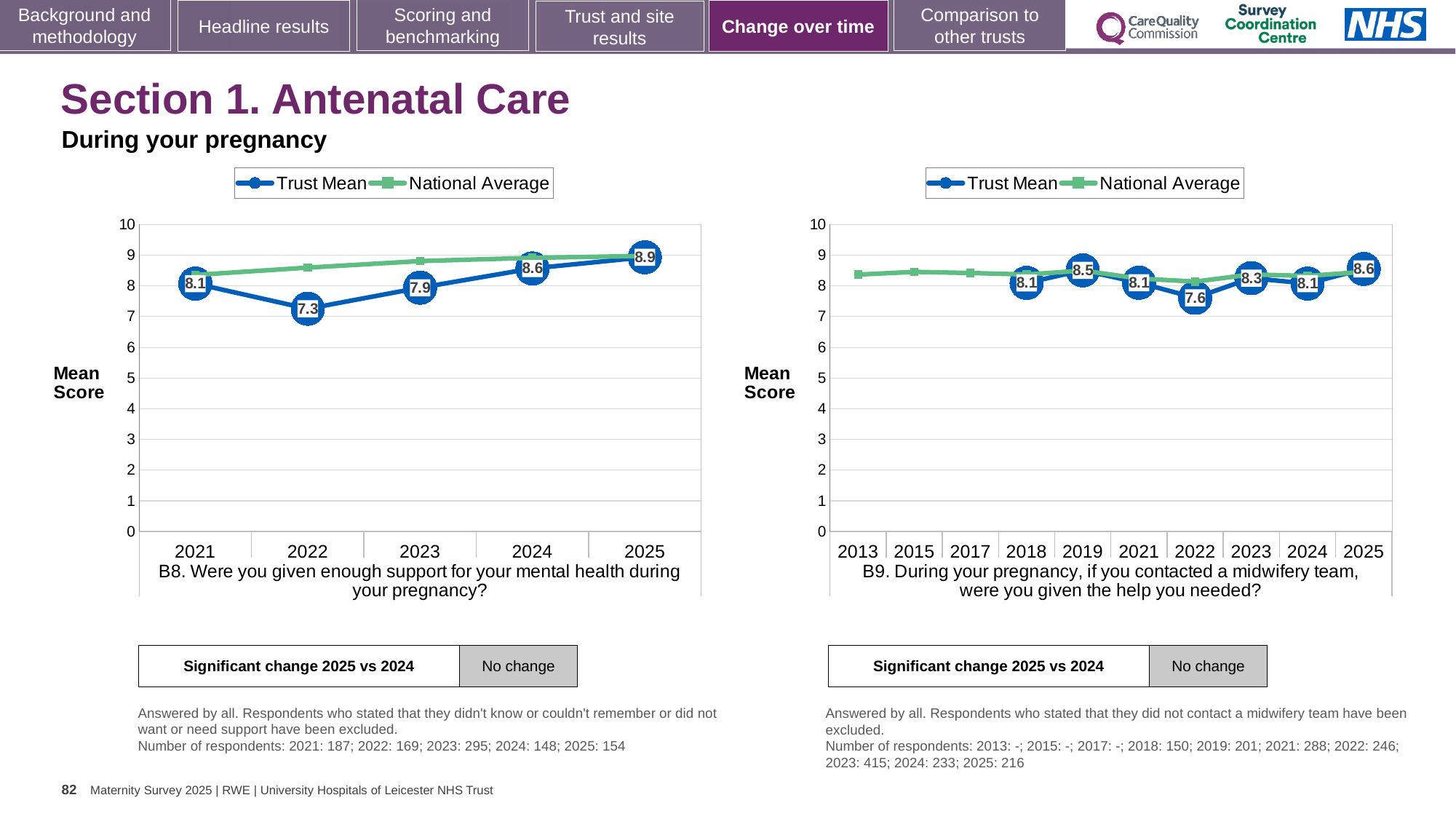
In the B9 chart on the right, which year has the highest Trust Mean? 2025 In the B9 chart on the right, what is the Trust Mean for 2022? 7.6 In the B8 chart on the left, what is the Trust Mean for 2022? 7.3 In the B8 chart on the left, what is the difference between the Trust Mean for 2025 and 2021? 0.8 In the B8 chart on the left, what is the Trust Mean for 2025? 8.9 In the B8 chart on the left, which year has the lowest Trust Mean? 2022 How many series does the legend of the B8 chart on the left list? 2 In the B8 chart on the left, how many years are shown on the x axis? 5 In the B9 chart on the right, is the Trust Mean for 2019 or 2022 larger? 2019 In the B9 chart on the right, how many years are shown on the x axis? 10 In the B8 chart on the left, does the Trust Mean rise or fall from 2022 to 2025? rise In the B9 chart on the right, is the National Average for 2013 greater or less than 7? greater